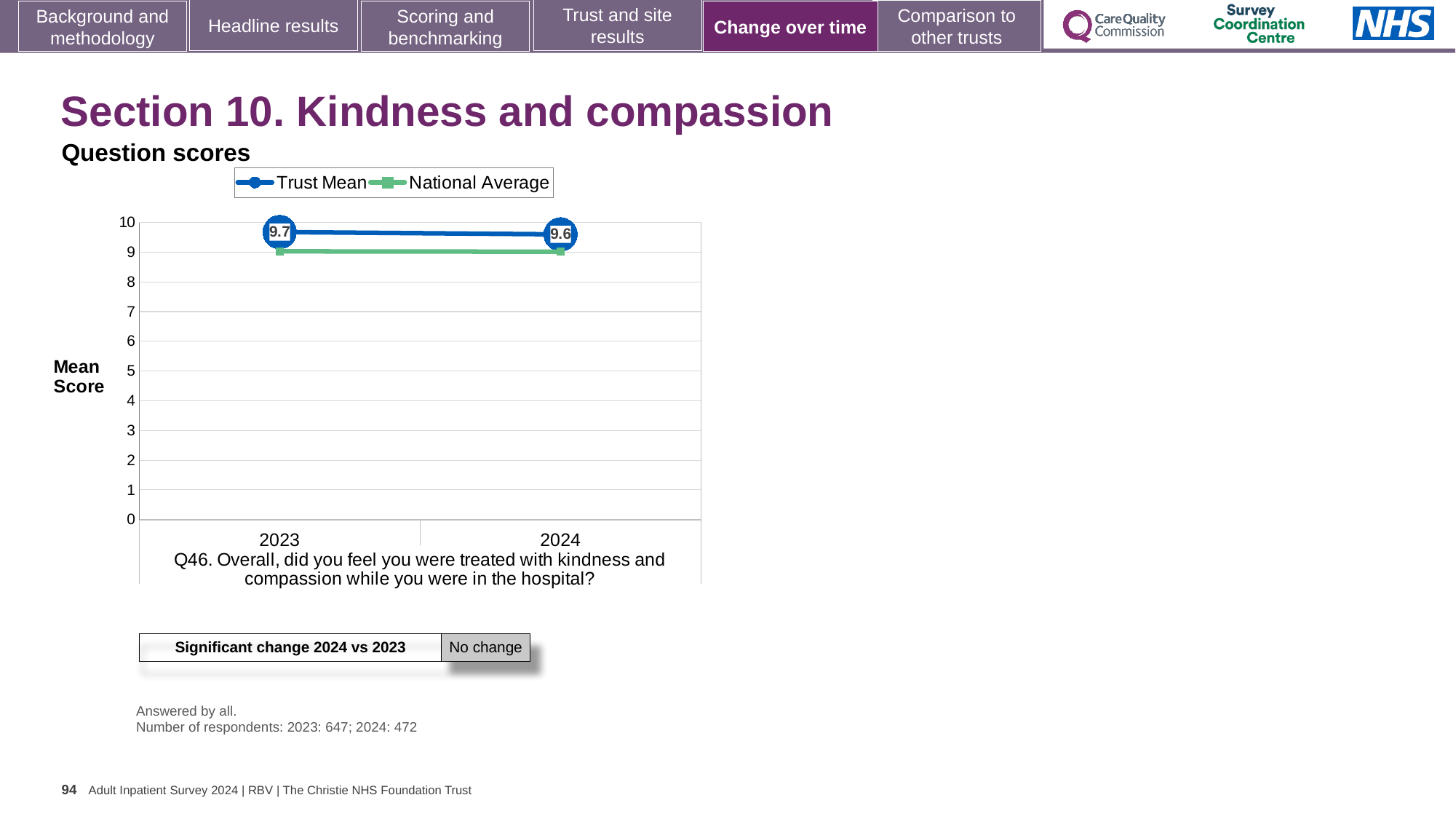
What kind of chart is shown on the slide? line chart How many years are plotted on the x axis? 2 In which year is the Trust Mean score lowest? 2024 In which year is the Trust Mean score highest? 2023 Does the Trust Mean rise or fall from 2023 to 2024? fall Is the National Average value for 2024 greater or less than 8? greater How many series does the legend list? 2 In 2023, which is higher: the Trust Mean or the National Average? Trust Mean What is the difference between the Trust Mean scores for 2023 and 2024? 0.1 What is the Trust Mean score for 2023? 9.7 What is the Trust Mean score for 2024? 9.6 What is the label on the y axis of the chart? Mean Score